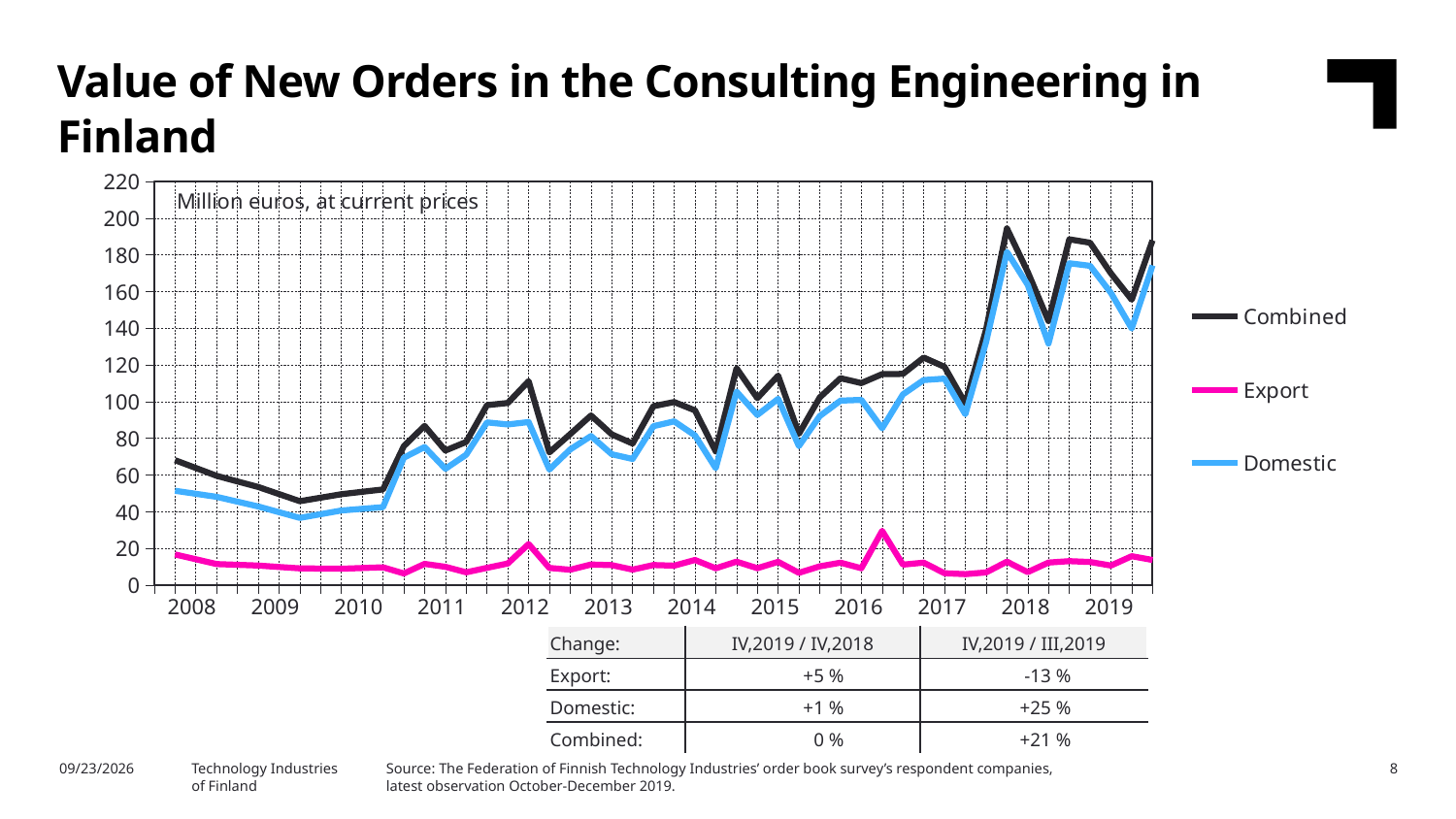
How many series does the legend list? 3 Does the Combined line overall rise or fall from 2008 to 2019? rise Is the highest value of the Export line (in 2016) greater or less than 40? less How many years are labelled on the x axis? 12 What unit is stated in the chart's annotation? Million euros, at current prices Is the Domestic value at the start of 2008 greater or less than 60? less Is the peak value of the Combined line in 2018 greater or less than 180? greater Which series has the lowest values throughout the chart? Export Which is larger in 2019, the Domestic line or the Export line? Domestic What kind of chart is shown on the slide? line chart Which series has the highest values throughout the chart? Combined Which colour is used for the Export line? pink